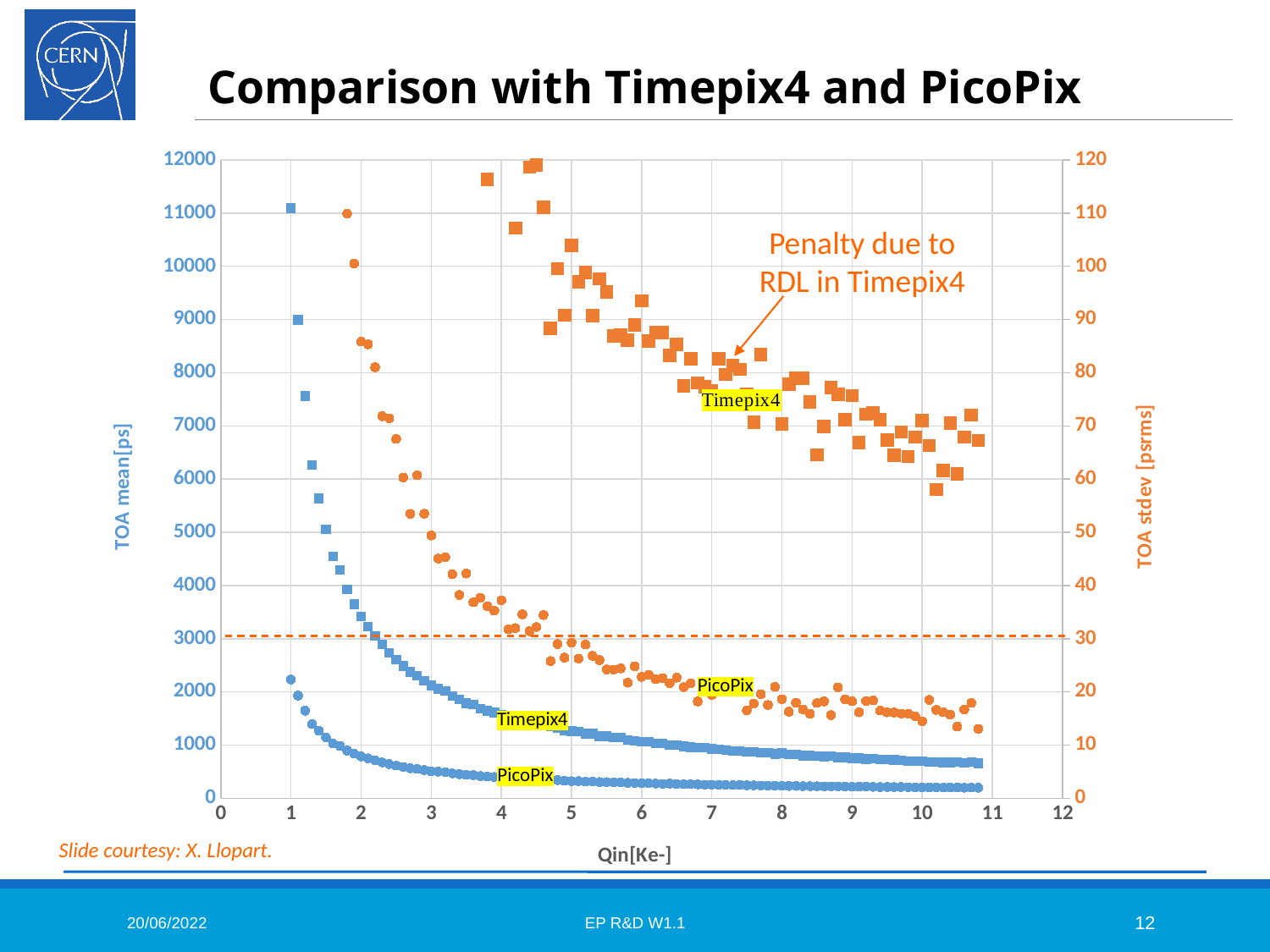
What does the annotation with the arrow pointing at the orange Timepix4 points say? Penalty due to RDL in Timepix4 At Qin = 8 Ke-, which has the larger TOA stdev, Timepix4 or PicoPix? Timepix4 As Qin increases, does the TOA mean for Timepix4 (blue squares) rise or fall? Fall Is the TOA mean for Timepix4 at Qin = 10 Ke- greater or less than 1000 ps? less At what value on the right-hand TOA stdev axis is the dashed horizontal line drawn? 30 What kind of chart is shown on the slide? Scatter chart Is the TOA stdev for Timepix4 at Qin = 4.5 Ke- greater or less than 100 psrms? greater Is the TOA stdev for PicoPix at Qin = 10 Ke- greater or less than 30 psrms? less As Qin increases from 5 to 11, does the TOA stdev for PicoPix (orange circles) rise or fall? Fall What is the title of the chart on the slide? Comparison with Timepix4 and PicoPix At Qin = 10 Ke-, which has the higher TOA mean, Timepix4 or PicoPix? Timepix4